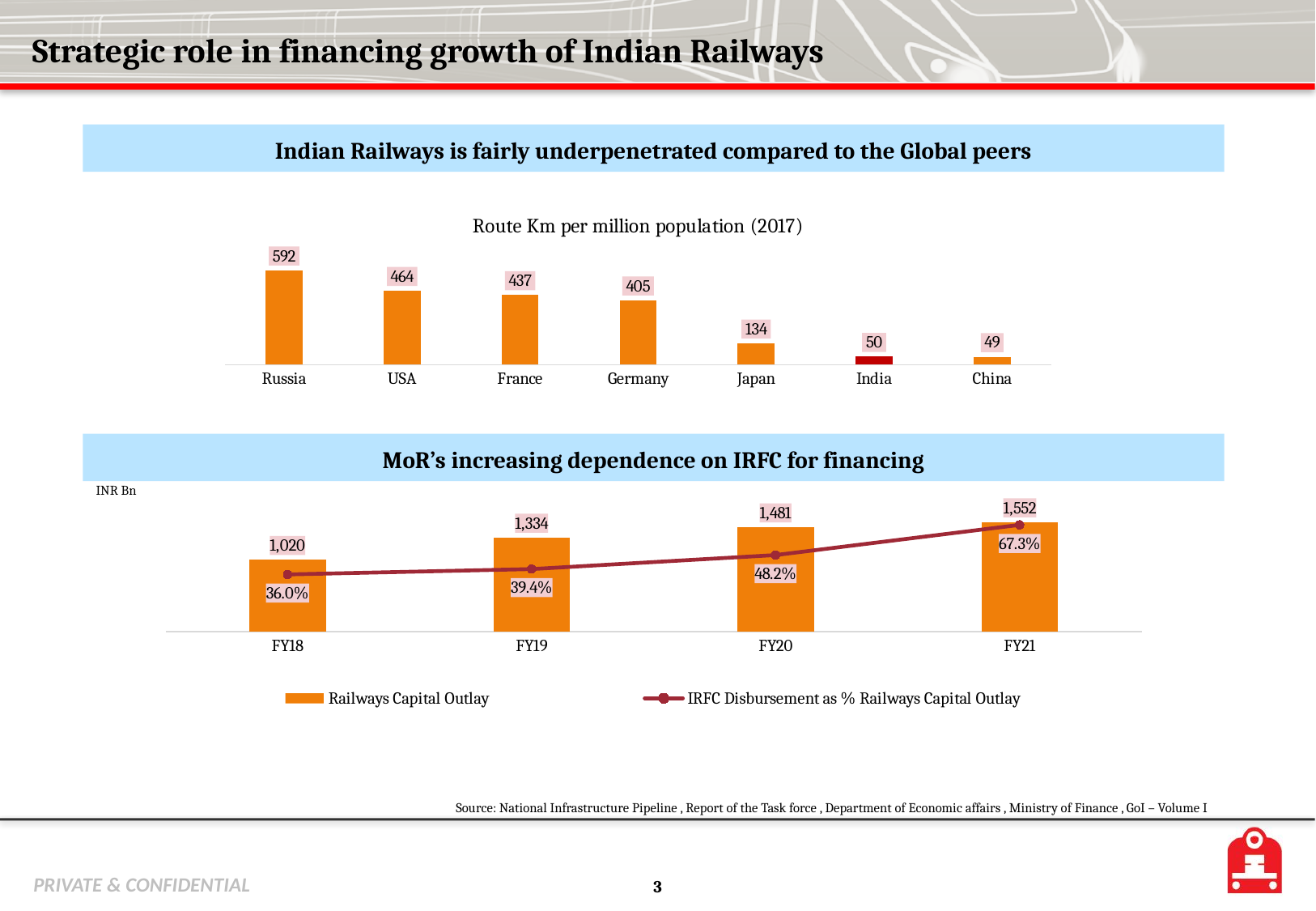
In the 'Route Km per million population (2017)' chart, which country's bar is coloured red rather than orange? India In the 'MoR's increasing dependence on IRFC for financing' chart, what is the Railways Capital Outlay for FY19? 1,334 In the 'MoR's increasing dependence on IRFC for financing' chart, what is the difference in Railways Capital Outlay between FY21 and FY18? 532 In the 'Route Km per million population (2017)' chart, what is the value for Russia? 592 In the 'Route Km per million population (2017)' chart, how many countries are shown? 7 In the 'Route Km per million population (2017)' chart, which is larger, the value for Japan or the value for India? Japan In the 'MoR's increasing dependence on IRFC for financing' chart, what is IRFC Disbursement as % Railways Capital Outlay for FY20? 48.2% In the 'MoR's increasing dependence on IRFC for financing' chart, does the Railways Capital Outlay rise or fall from FY18 to FY21? Rise In the 'MoR's increasing dependence on IRFC for financing' chart, how many series does the legend list? 2 In the 'Route Km per million population (2017)' chart, what is the difference between the values for USA and Germany? 59 What type of chart is the 'Route Km per million population (2017)' chart? Bar chart In the 'Route Km per million population (2017)' chart, which country has the lowest value? China